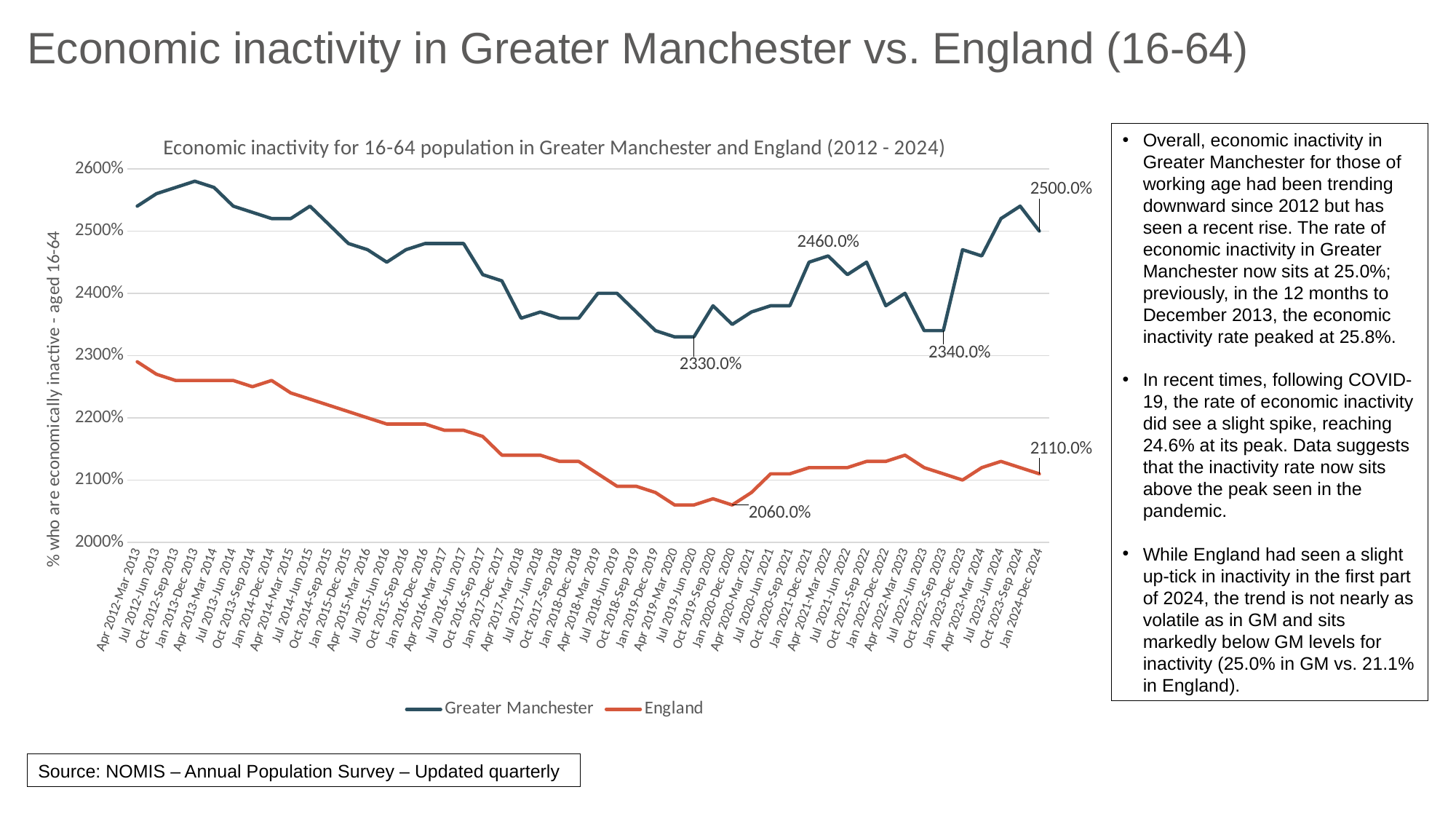
What is the difference between the Greater Manchester and England values at Jan 2024-Dec 2024? 390.0% What is the labelled value for Greater Manchester at Jan 2024-Dec 2024? 2500.0% Does the England line generally rise or fall between Apr 2012-Mar 2013 and Jul 2019-Jun 2020? fall Is the Greater Manchester value for Apr 2012-Mar 2013 greater or less than 2500%? greater At Jan 2024-Dec 2024, which series has the higher value, Greater Manchester or England? Greater Manchester What type of chart is shown on the slide? line chart What is the title of the chart? Economic inactivity for 16-64 population in Greater Manchester and England (2012 - 2024) What is the labelled value for England at Jan 2024-Dec 2024? 2110.0% What are the two entries in the chart legend? Greater Manchester and England What is the lowest labelled value shown on the England line? 2060.0% How many series does the chart legend list? 2